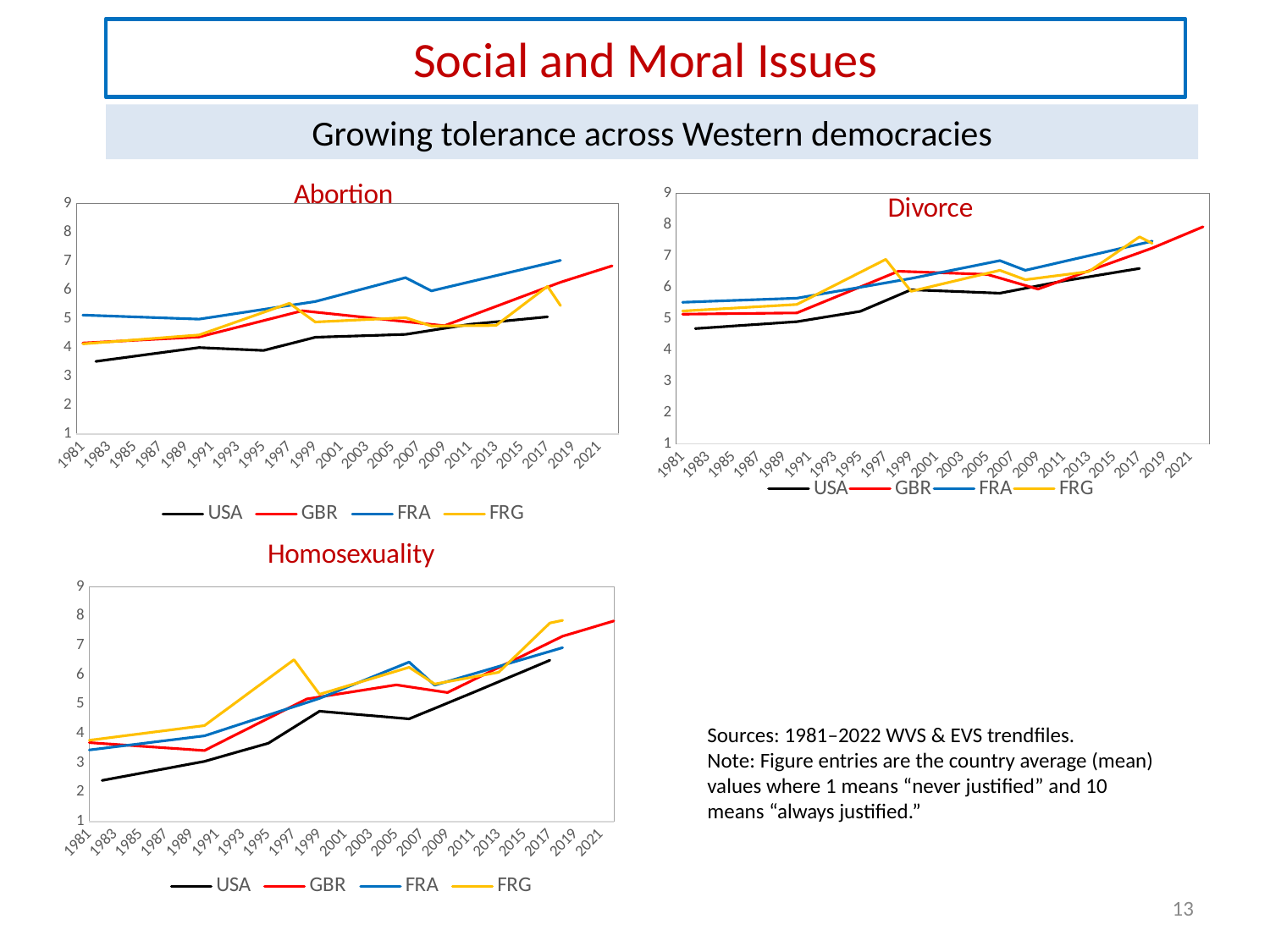
In the Abortion chart, which is higher in 1981, USA or FRA? FRA Which series are listed in the legend of the Homosexuality chart? USA, GBR, FRA, FRG In the Abortion chart, which series has the lowest value in 1981? USA In the Homosexuality chart, does the USA line rise or fall from 1981 to 2017? rise In the Divorce chart, is the USA value in 1981 greater or less than 5? less In the Divorce chart, is the GBR value in 2021 greater or less than 7? greater What kind of chart is the Abortion chart? line chart In the Homosexuality chart, is the USA value in 1981 greater or less than 3? less How many series does the legend of the Divorce chart list? 4 In the Homosexuality chart, which is higher in 1981, USA or FRG? FRG How many charts are shown on the slide? 3